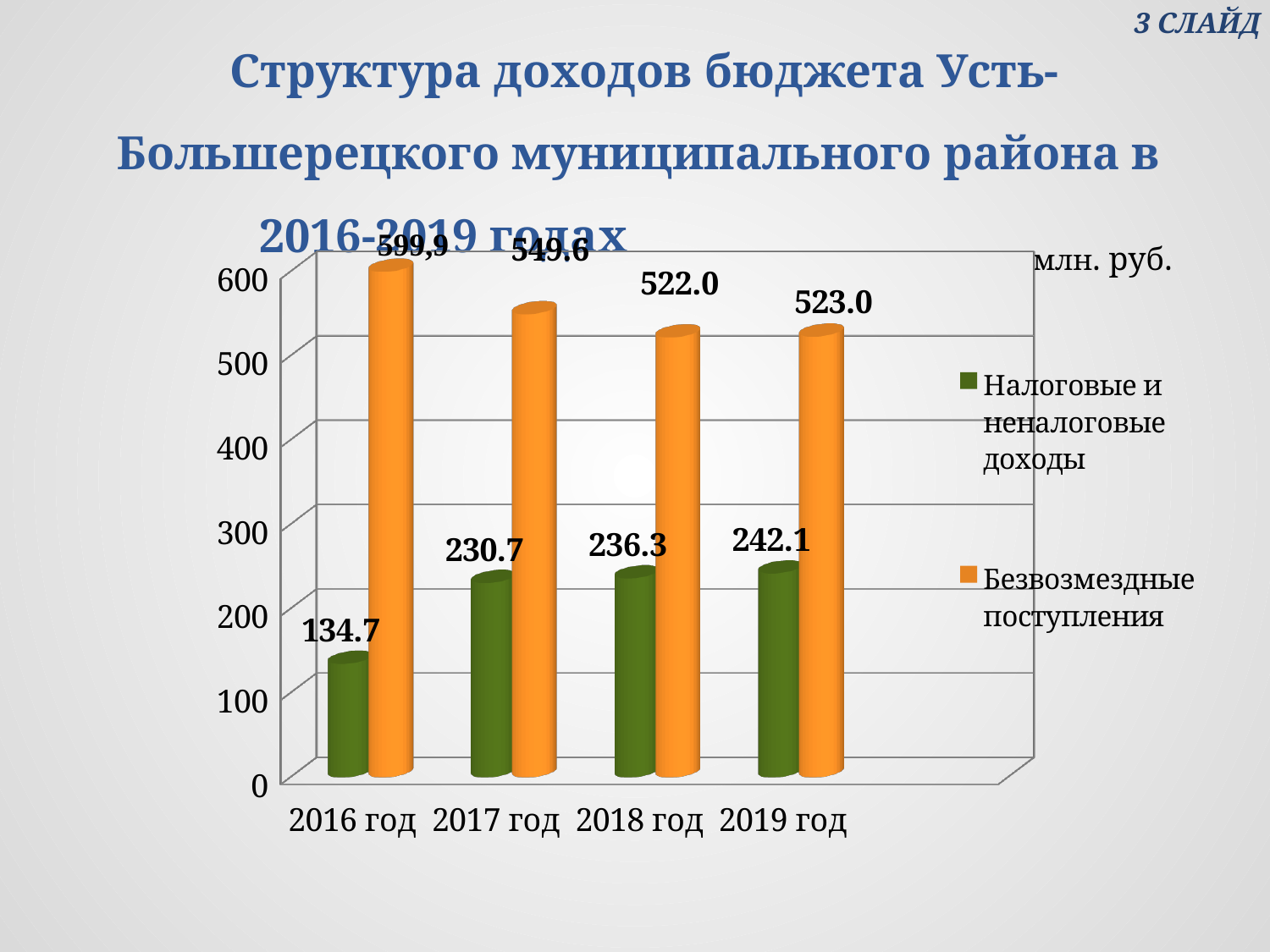
What is the value for Налоговые и неналоговые доходы in 2019 год? 242.1 In which year is the value for Налоговые и неналоговые доходы the lowest? 2016 год What kind of chart is shown on the slide? bar chart How many series does the legend list? 2 What is the value for Безвозмездные поступления in 2017 год? 549.6 What is the difference between Налоговые и неналоговые доходы in 2019 год and in 2016 год? 107.4 Is the value for Безвозмездные поступления in 2019 год greater or less than 500? greater Which is larger in 2018 год: Налоговые и неналоговые доходы or Безвозмездные поступления? Безвозмездные поступления In which year is the value for Безвозмездные поступления the highest? 2016 год What is the value for Безвозмездные поступления in 2018 год? 522.0 How many years are shown on the x axis? 4 What is the value for Налоговые и неналоговые доходы in 2017 год? 230.7